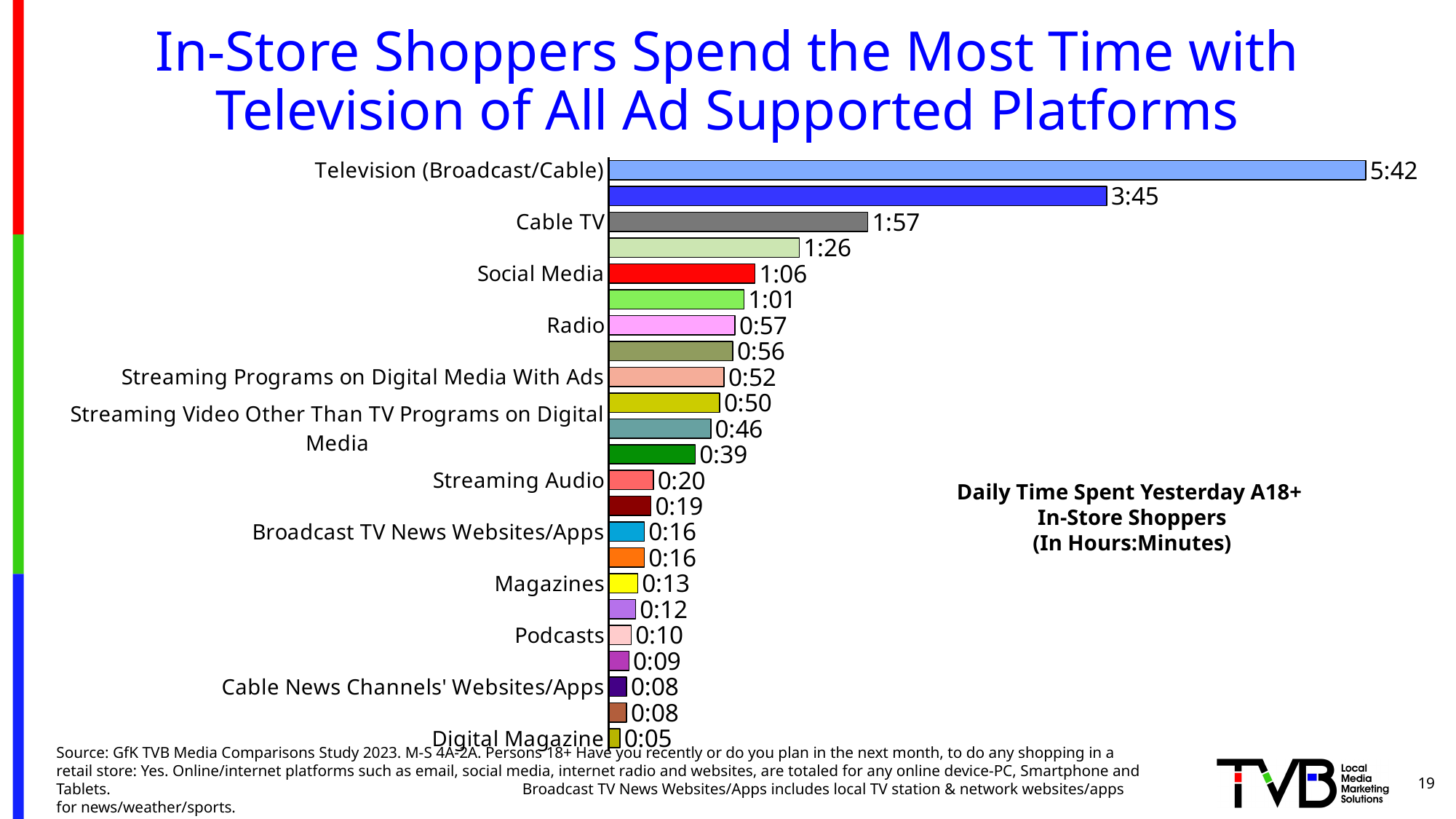
What is the value shown for Cable TV? 1:57 What is the value for Streaming Audio? 0:20 How many bars are plotted in the chart? 23 What is the value shown for Digital Magazine? 0:05 Which has a larger value, Social Media or Radio? Social Media How much daily time do in-store shoppers spend with Social Media? 1:06 Which platform has the lowest daily time spent? Digital Magazine What is the difference between the Television (Broadcast/Cable) value and the Cable TV value? 3:45 Which platform has the highest daily time spent? Television (Broadcast/Cable) What kind of chart is shown on the slide? Bar chart What is the value shown for Radio? 0:57 What is the daily time spent with Television (Broadcast/Cable) by in-store shoppers? 5:42